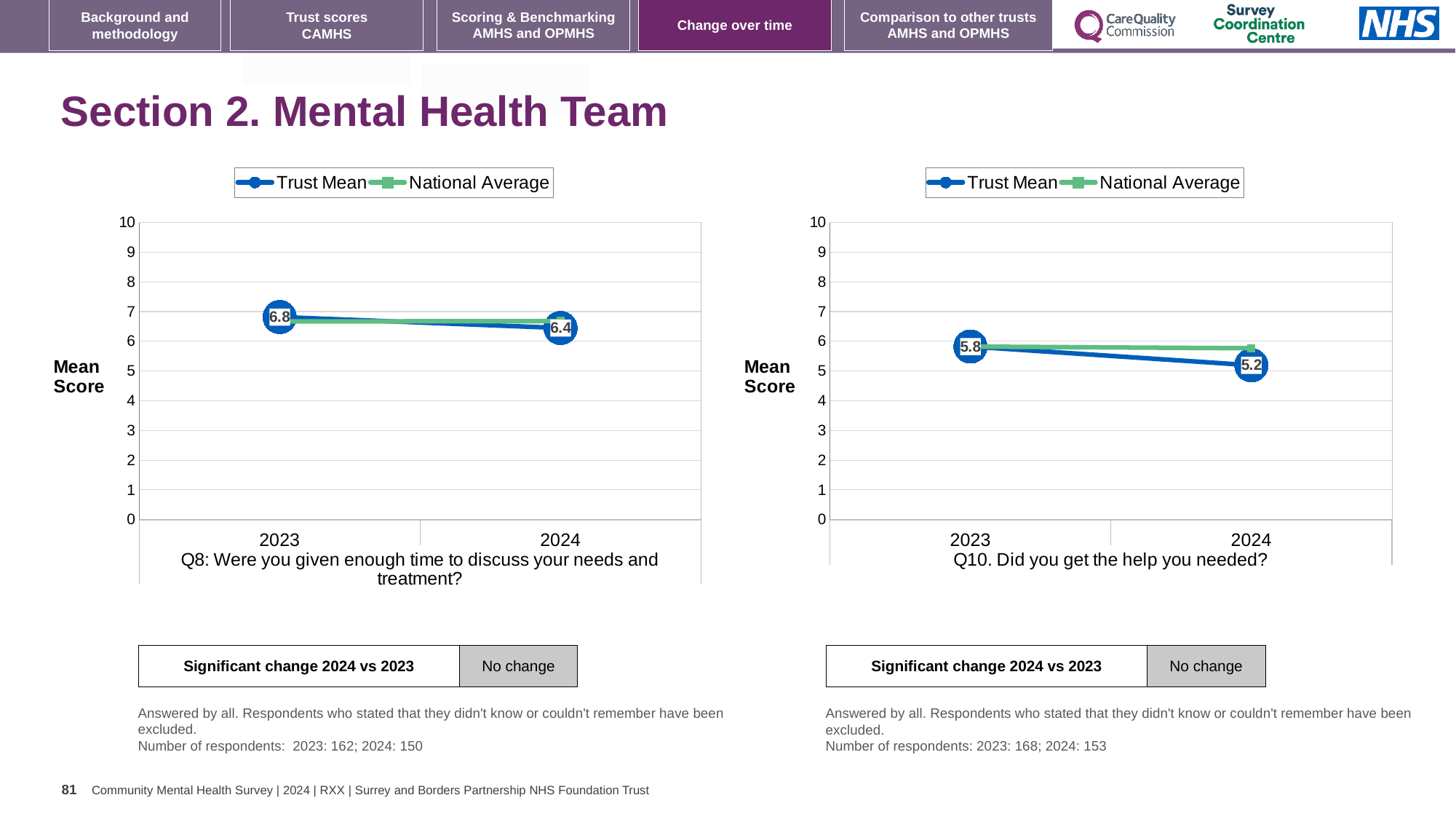
On the right chart (Q10), is the National Average for 2024 greater or less than 5? greater On the left chart (Q8), by how much did the Trust Mean change from 2023 to 2024? 0.4 On the left chart (Q8), what is the Trust Mean for 2024? 6.4 On the left chart (Q8: Were you given enough time to discuss your needs and treatment?), what is the Trust Mean for 2023? 6.8 On the right chart (Q10), does the Trust Mean rise or fall from 2023 to 2024? fall On the right chart (Q10. Did you get the help you needed?), what is the Trust Mean for 2023? 5.8 What kind of chart is the left chart (Q8)? line chart How many years are plotted on the x axis of the left chart (Q8)? 2 How many series does the legend of the right chart (Q10) list? 2 On the right chart (Q10), what is the difference between the Trust Mean in 2023 and 2024? 0.6 On the right chart (Q10), what is the Trust Mean for 2024? 5.2 On the left chart (Q8), is the Trust Mean for 2023 greater or less than the Trust Mean for 2024? greater